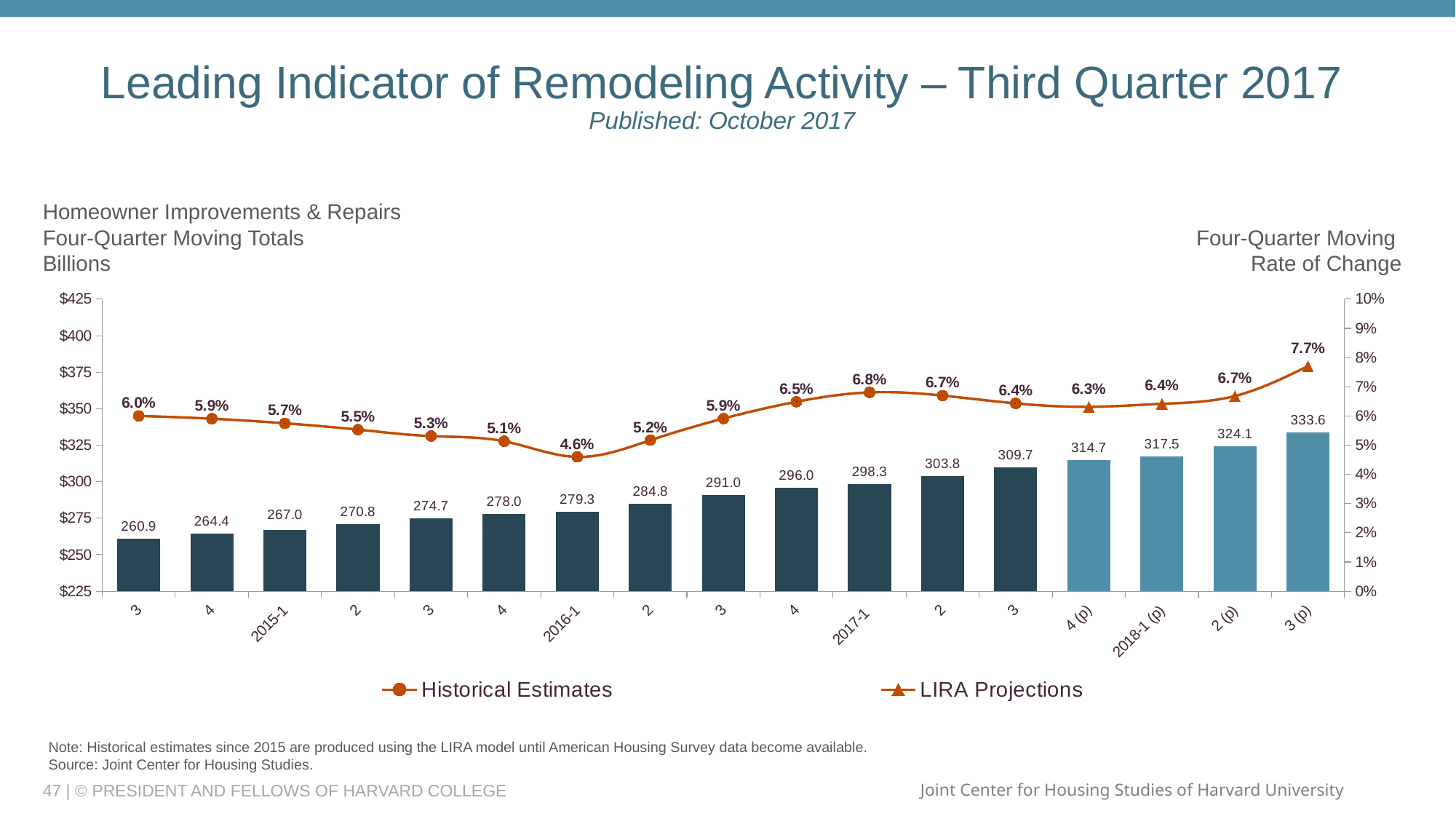
What is the four-quarter moving total (in billions) for 2017-1? 298.3 What is the four-quarter moving rate of change for 2016-1? 4.6% What is the rate of change shown for 2018-1 (p)? 6.4% Which period has the highest four-quarter moving rate of change? 3 (p) How many series does the legend list? 2 Which period has the lowest four-quarter moving rate of change? 2016-1 Is the four-quarter moving total for 2016-1 greater or less than $300? less How many bars are plotted in the chart? 17 Which is larger, the rate of change for 2017-1 or for 2015-1? 2017-1 What are the two series named in the legend? Historical Estimates and LIRA Projections What is the difference between the four-quarter moving totals for 3 (p) and 2 (p)? 9.5 What is the four-quarter moving total for 3 (p)? 333.6